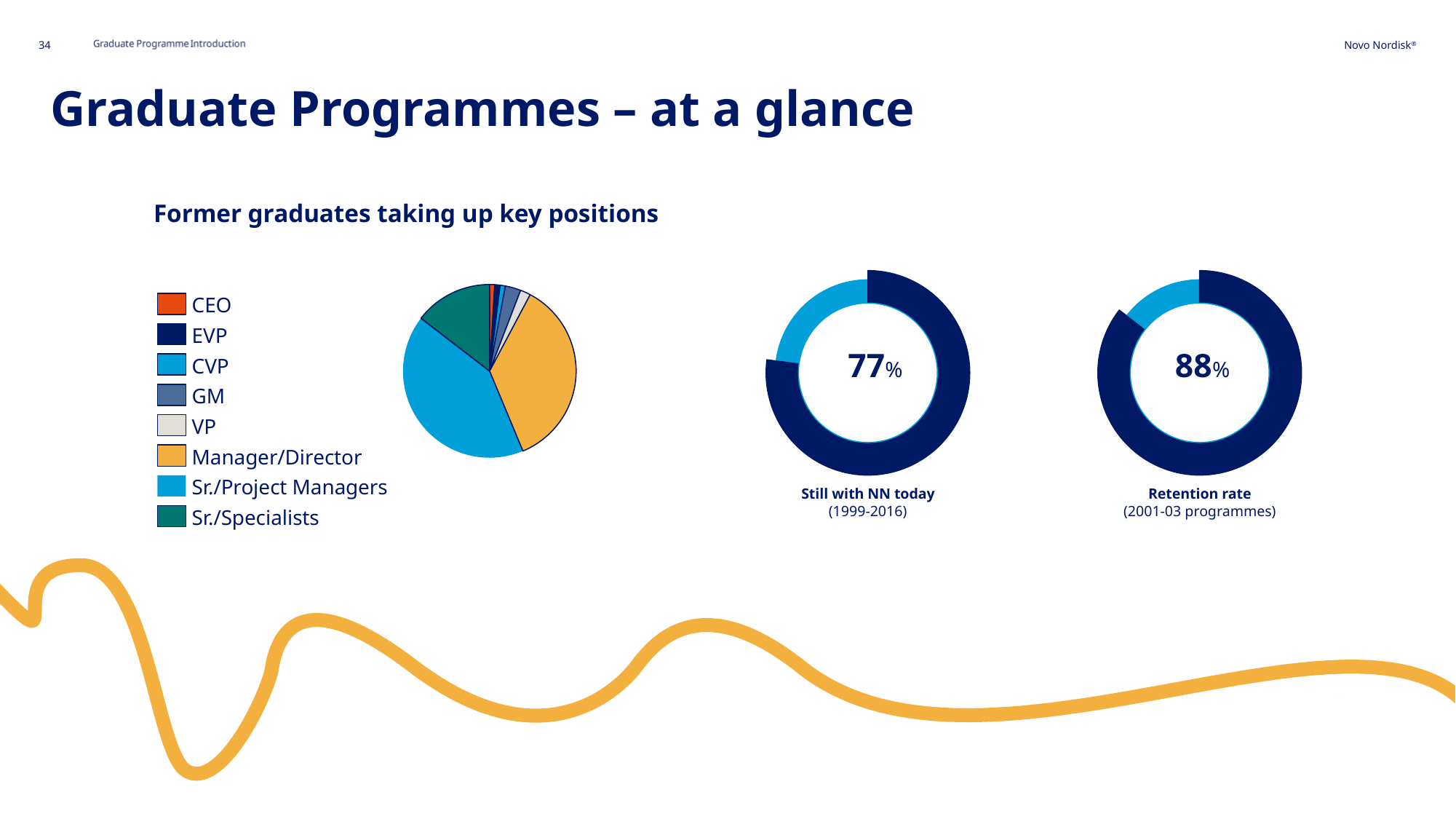
What value is shown in the 'Retention rate' donut chart? 88% What kind of chart is the 'Former graduates taking up key positions' chart on the left? pie chart Which donut chart shows the higher value: 'Still with NN today' or 'Retention rate'? Retention rate In the 'Former graduates taking up key positions' pie chart, which slice is larger: Sr./Specialists or VP? Sr./Specialists How many charts are shown on the slide? 3 What is the title of the pie chart on the left of the slide? Former graduates taking up key positions How many categories does the legend of the 'Former graduates taking up key positions' pie chart list? 8 What is the difference between the 'Retention rate' value and the 'Still with NN today' value? 11 percentage points Which period does the 'Still with NN today' donut chart cover? 1999-2016 In the 'Former graduates taking up key positions' pie chart, which slice is larger: Manager/Director or Sr./Specialists? Manager/Director What value is shown in the 'Still with NN today' donut chart? 77%